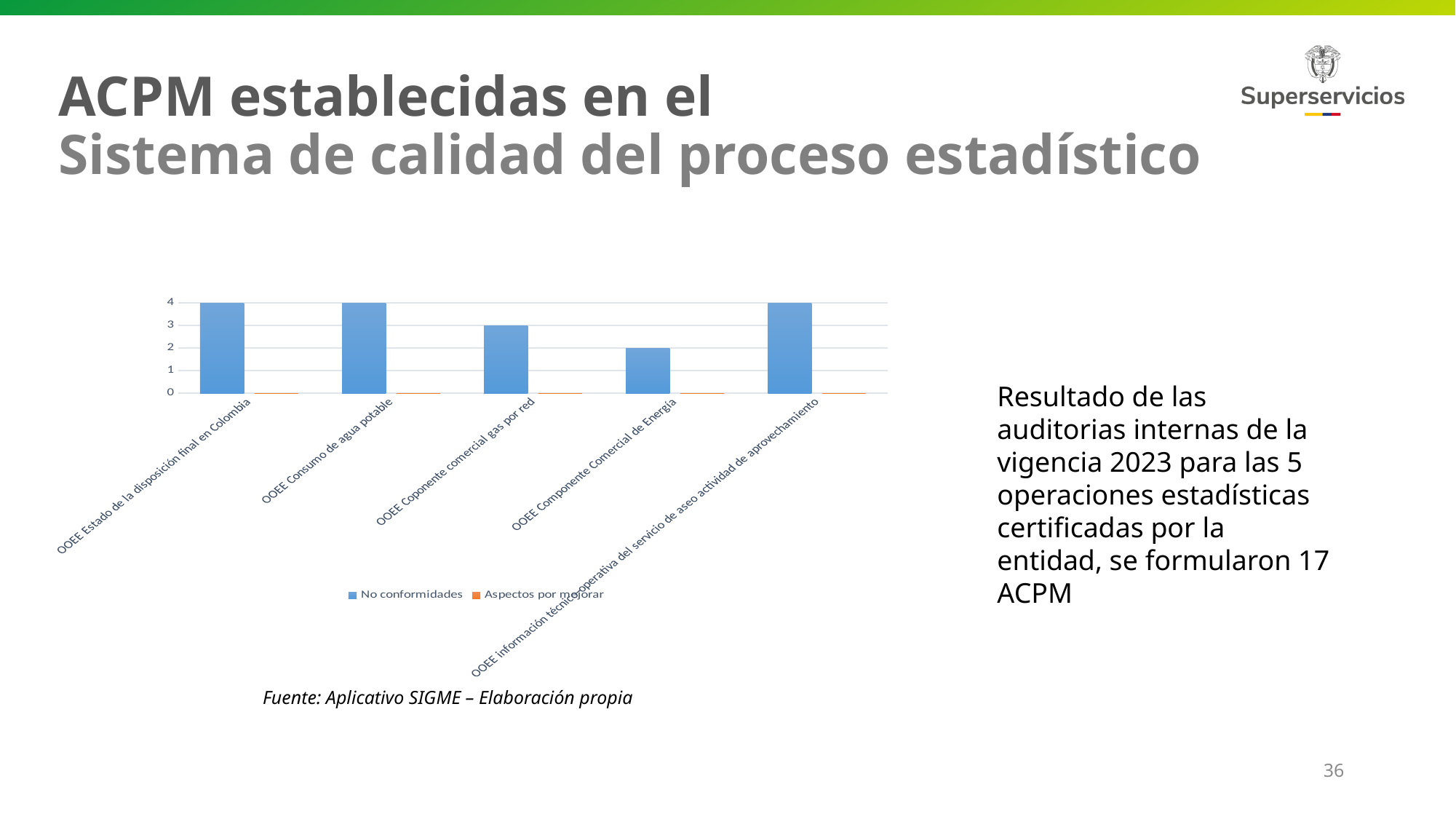
Which has more No conformidades: OOEE Coponente comercial gas por red or OOEE Componente Comercial de Energía? OOEE Coponente comercial gas por red How many categories are shown on the x axis of the chart? 5 Which series is shown in orange in the chart legend? Aspectos por mejorar What is the value of Aspectos por mejorar for OOEE Estado de la disposición final en Colombia? 0 What is the difference in No conformidades between OOEE Estado de la disposición final en Colombia and OOEE Componente Comercial de Energía? 2 What kind of chart is shown on the slide? bar chart Which category has the lowest value of No conformidades? OOEE Componente Comercial de Energía What is the value of No conformidades for OOEE Coponente comercial gas por red? 3 Which series is shown in blue in the chart legend? No conformidades What is the value of No conformidades for OOEE Componente Comercial de Energía? 2 What is the value of No conformidades for OOEE Consumo de agua potable? 4 How many series does the chart legend list? 2